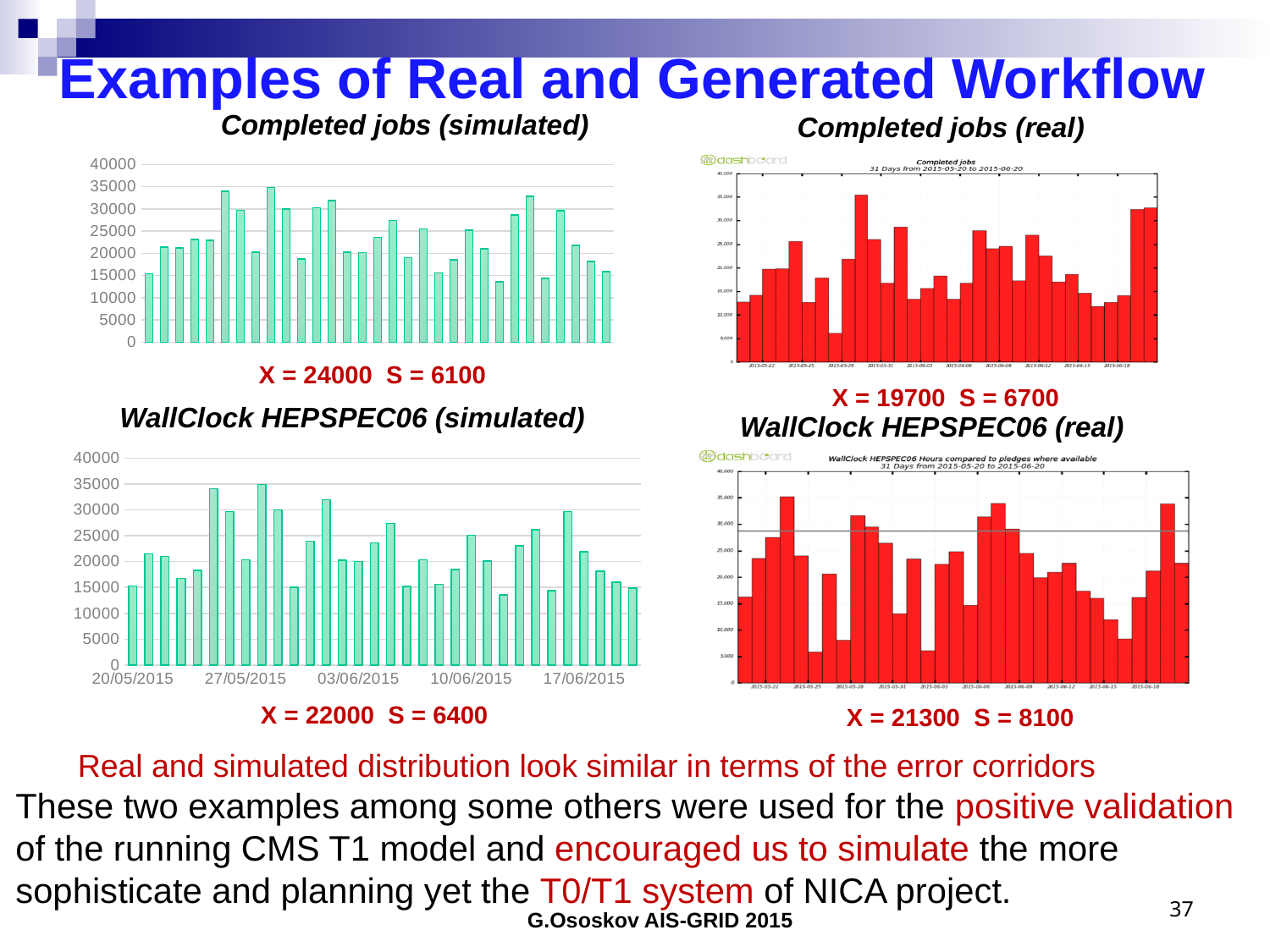
In the 'WallClock HEPSPEC06 (simulated)' chart, is the value of the first (leftmost) bar greater or less than 10000? greater What colour are the bars in the 'Completed jobs (real)' chart? red What is the highest value shown on the y axis of the 'Completed jobs (simulated)' chart? 40000 In the 'WallClock HEPSPEC06 (simulated)' chart, is the value of the last (rightmost) bar greater or less than 20000? less In the 'Completed jobs (simulated)' chart, is the value of the first (leftmost) bar greater or less than 20000? less What kind of chart is the 'WallClock HEPSPEC06 (simulated)' chart? bar chart How many charts are shown on the slide? 4 What kind of chart is the 'Completed jobs (simulated)' chart? bar chart